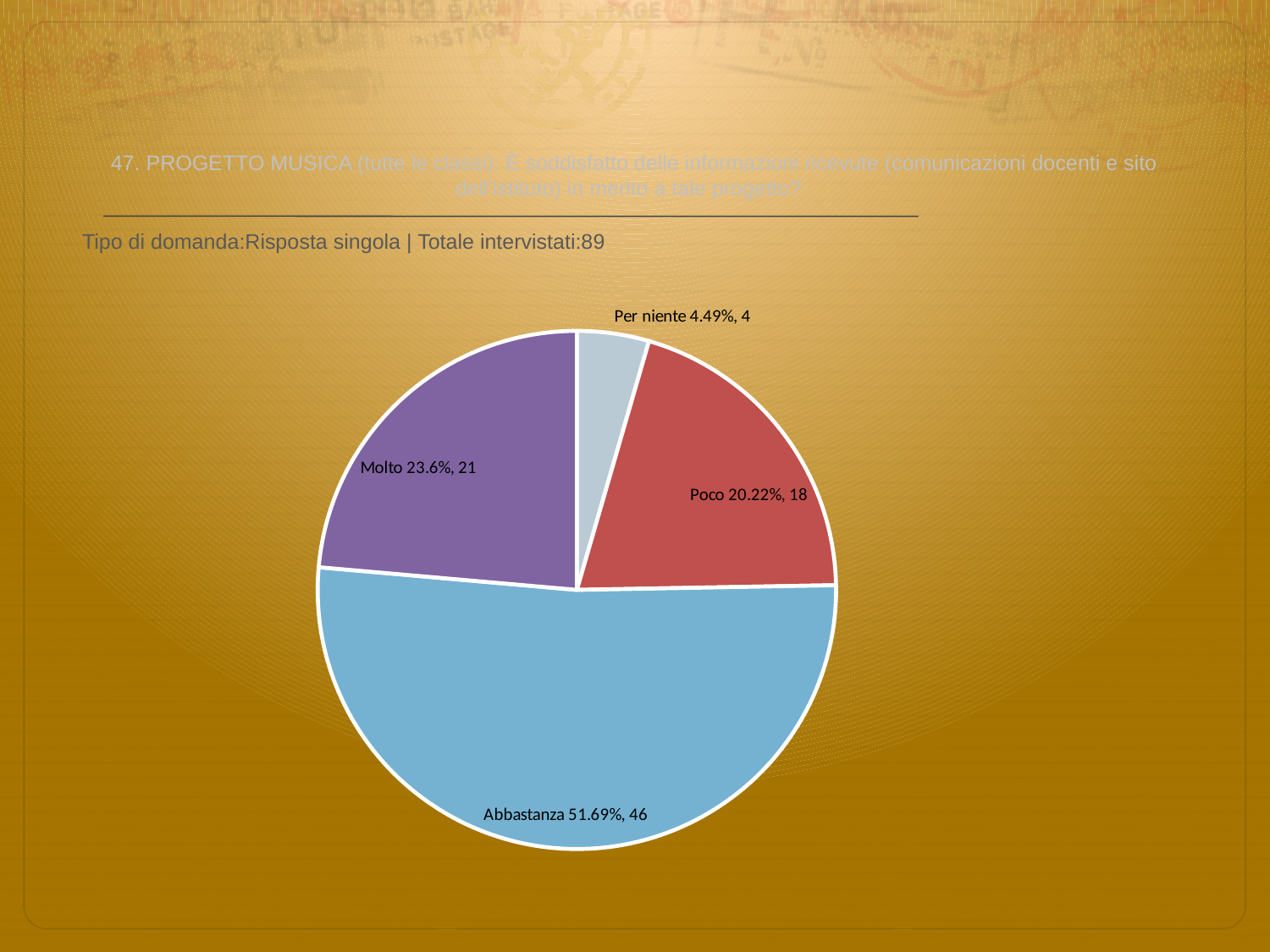
Which category has the largest slice? Abbastanza How many respondents answered Per niente? 4 Which category has the smallest slice? Per niente How many respondents answered Molto? 21 What is the total number of respondents shown in the pie chart? 89 What colour is the Abbastanza slice? blue What percentage share does the Poco slice have? 20.22% What percentage share does the Abbastanza slice have? 51.69% How many slices does the pie chart have? 4 Which has more respondents, Molto or Poco? Molto What kind of chart is shown on the slide? pie chart What is the difference in respondent count between Abbastanza and Molto? 25